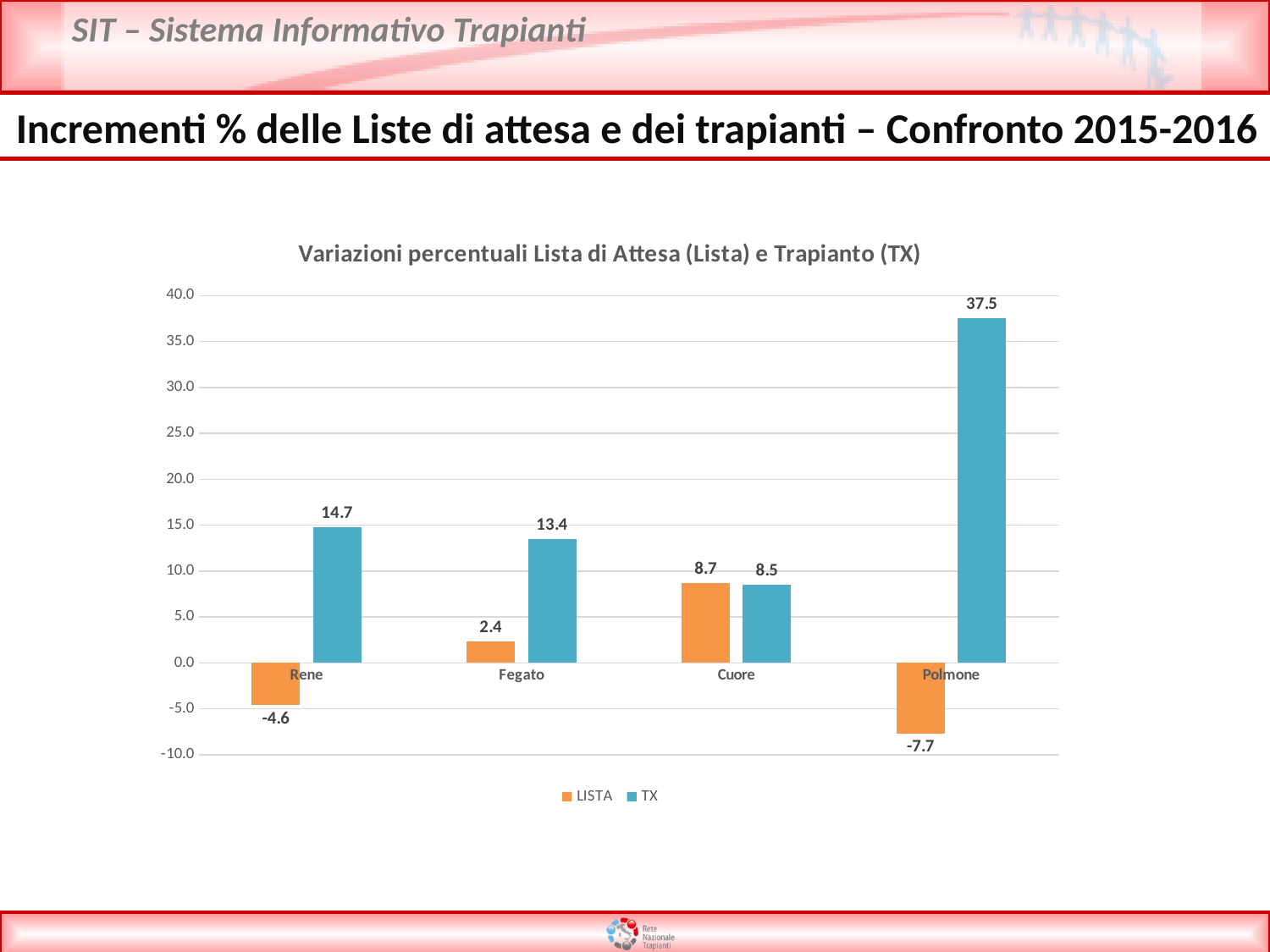
Which is larger for Fegato, the LISTA value or the TX value? TX What is the difference between the TX value and the LISTA value for Rene? 19.3 What is the TX value for Polmone? 37.5 Which category has the lowest LISTA value? Polmone What is the LISTA value for Rene? -4.6 How many series does the legend list? 2 What is the TX value for Fegato? 13.4 How many categories are shown on the x axis? 4 Which category has the highest TX value? Polmone What is the title of the chart? Variazioni percentuali Lista di Attesa (Lista) e Trapianto (TX) What is the LISTA value for Cuore? 8.7 What kind of chart is shown on the slide? Bar chart